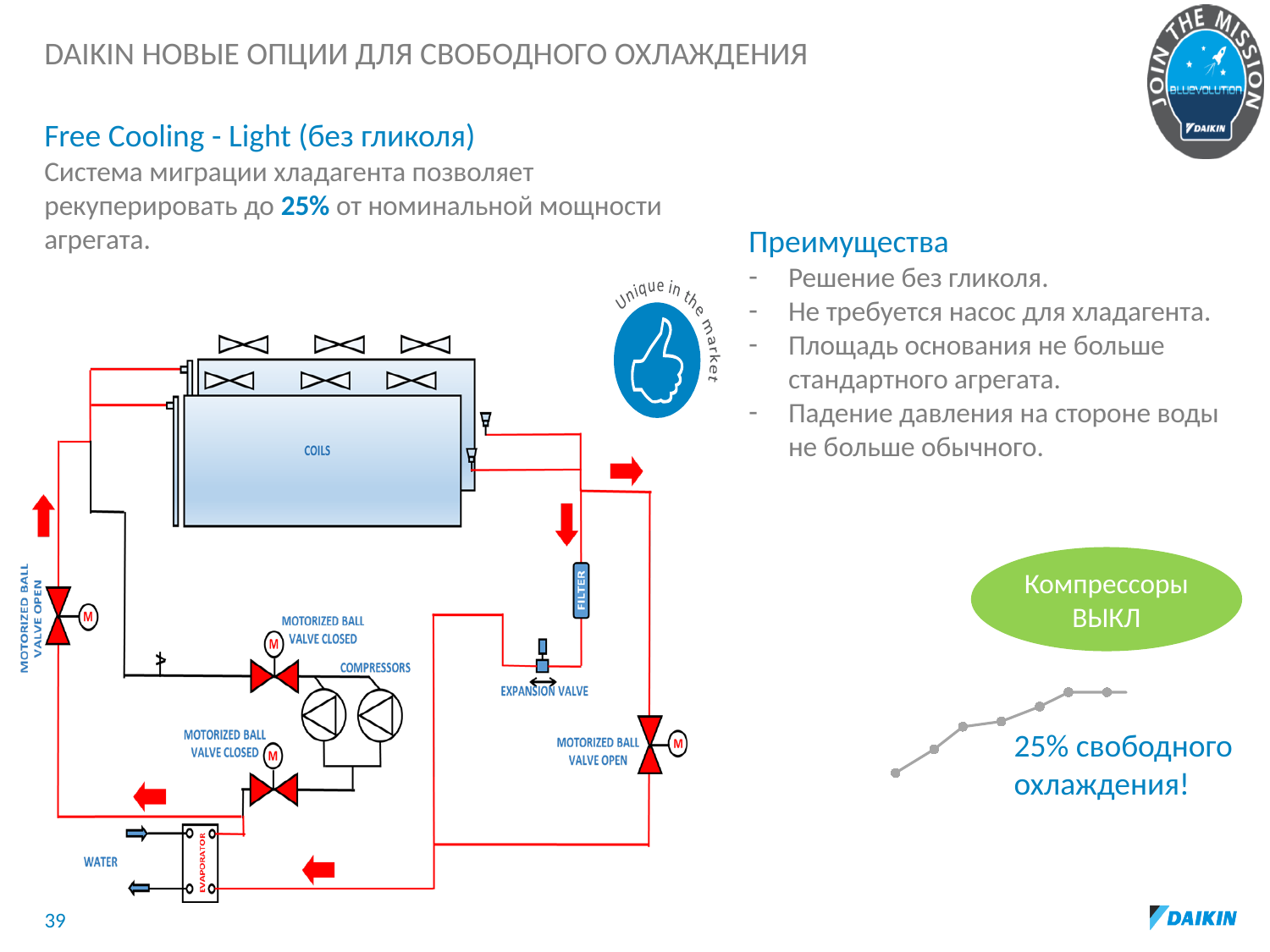
What kind of chart is the small chart in the lower right of the slide, next to the text "25% свободного охлаждения!"? line chart In the small line chart in the lower right of the slide, do the values rise or fall from left to right? rise What text is placed next to the small line chart in the lower right of the slide? 25% свободного охлаждения!